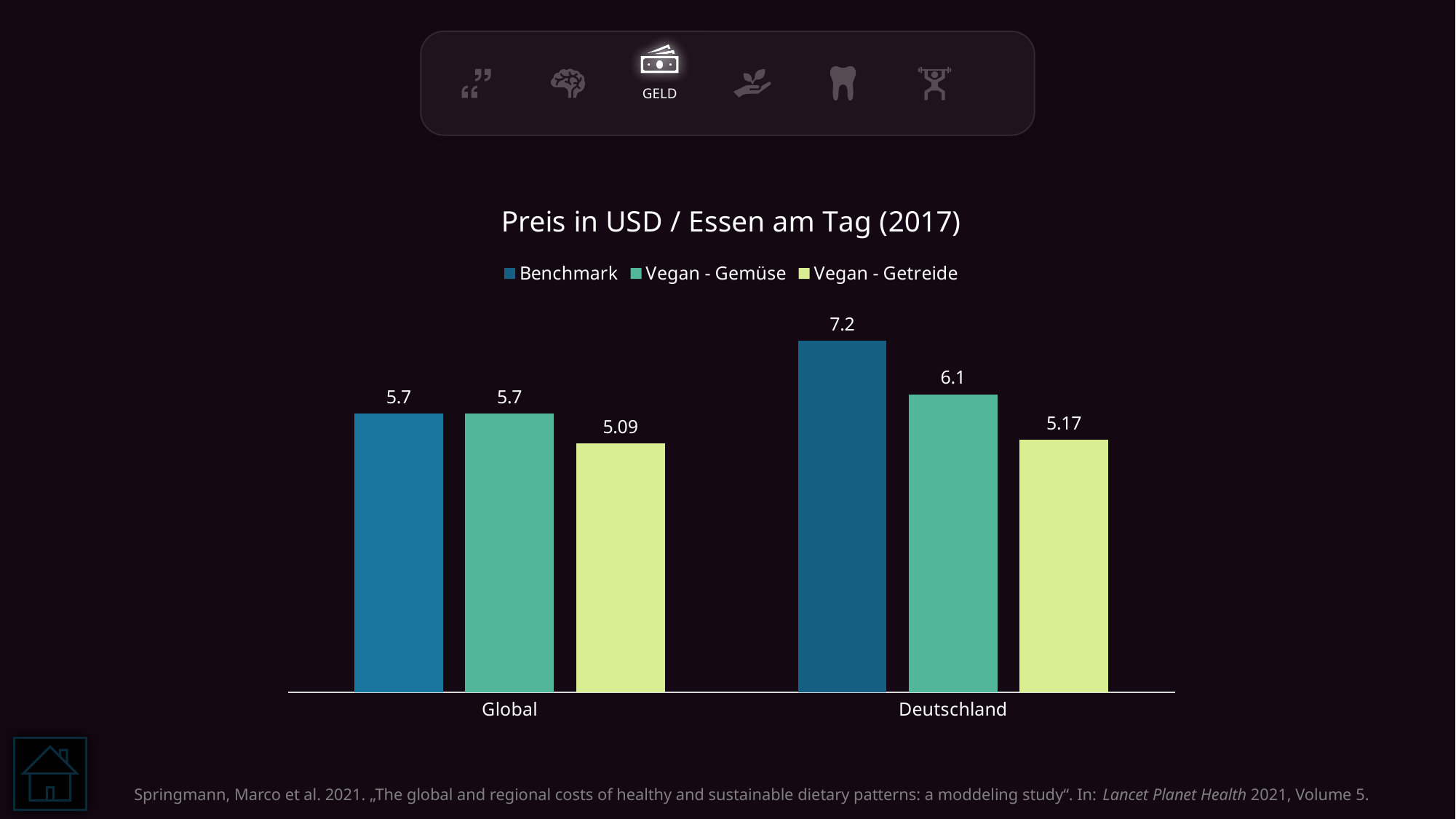
What is the difference between the Benchmark and Vegan - Getreide values for Deutschland? 2.03 Which series has the lowest value for Global? Vegan - Getreide What is the Vegan - Getreide value for Global? 5.09 What kind of chart is shown on the slide? Bar chart Which is larger: the Vegan - Gemüse value for Global or for Deutschland? Deutschland What is the Benchmark value for Deutschland? 7.2 What is the Vegan - Gemüse value for Deutschland? 6.1 How many categories are shown on the x axis? 2 What is the difference between the Benchmark values for Deutschland and Global? 1.5 Which series has the highest value for Deutschland? Benchmark How many series does the legend list? 3 What is the Vegan - Getreide value for Deutschland? 5.17